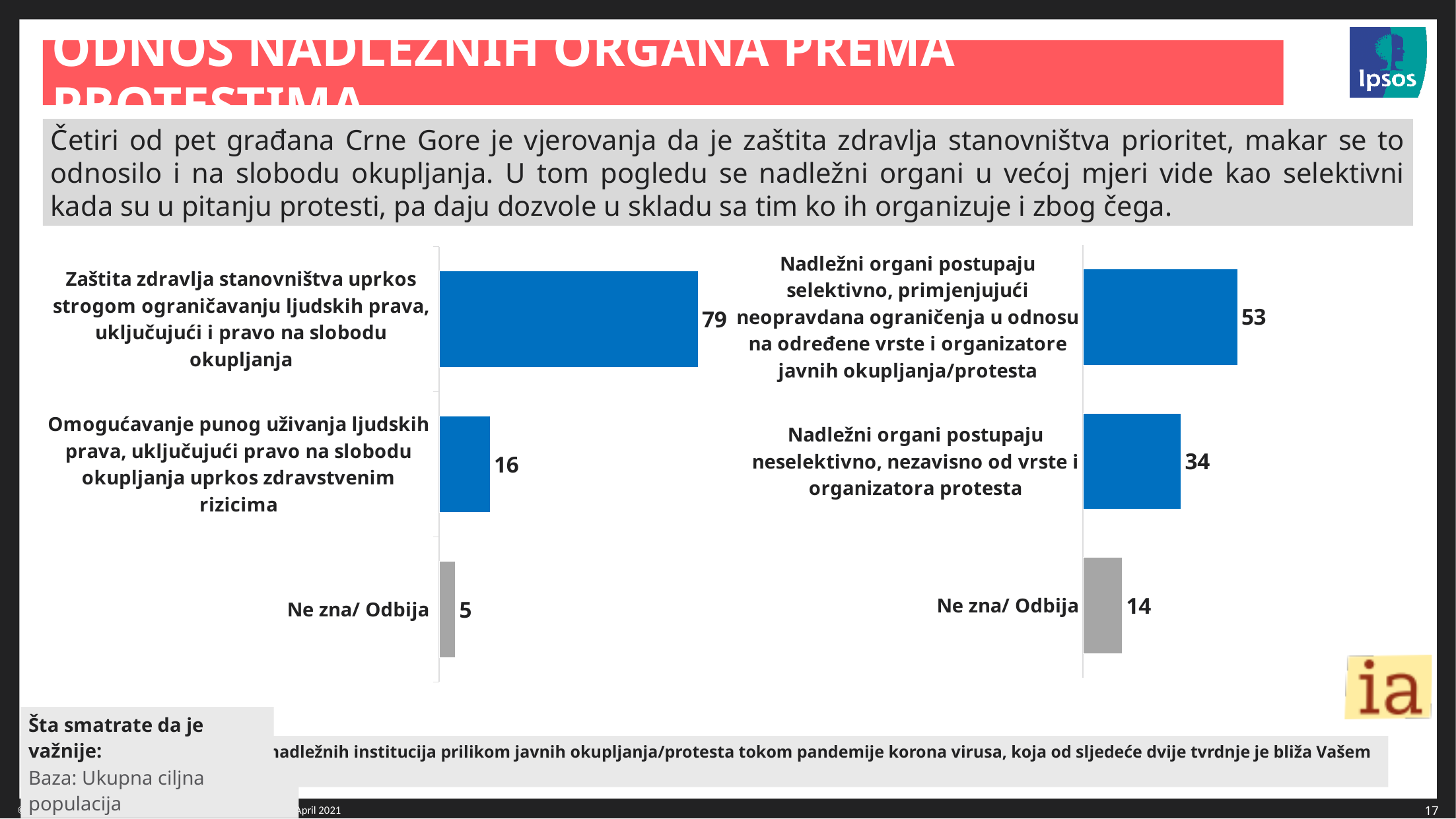
In the left chart, what is the difference between the value for "Zaštita zdravlja stanovništva..." and the value for "Omogućavanje punog uživanja ljudskih prava..."? 63 In the right chart, what is the value for "Nadležni organi postupaju selektivno, primjenjujući neopravdana ograničenja u odnosu na određene vrste i organizatore javnih okupljanja/protesta"? 53 In the left chart, which category has the lowest value? Ne zna/ Odbija Which is larger: the "Ne zna/ Odbija" value in the left chart or the "Ne zna/ Odbija" value in the right chart? The right chart In the left chart, what is the value for "Omogućavanje punog uživanja ljudskih prava, uključujući pravo na slobodu okupljanja uprkos zdravstvenim rizicima"? 16 How many categories does the left chart show? 3 In the right chart, which category has the highest value? Nadležni organi postupaju selektivno, primjenjujući neopravdana ograničenja u odnosu na određene vrste i organizatore javnih okupljanja/protesta In the left chart, what is the value for "Ne zna/ Odbija"? 5 In the right chart, what is the value for "Nadležni organi postupaju neselektivno, nezavisno od vrste i organizatora protesta"? 34 In the right chart, what is the value for "Ne zna/ Odbija"? 14 In the right chart, what is the difference between the value for "Nadležni organi postupaju selektivno..." and the value for "Nadležni organi postupaju neselektivno..."? 19 In the left chart, what is the value for "Zaštita zdravlja stanovništva uprkos strogom ograničavanju ljudskih prava, uključujući i pravo na slobodu okupljanja"? 79